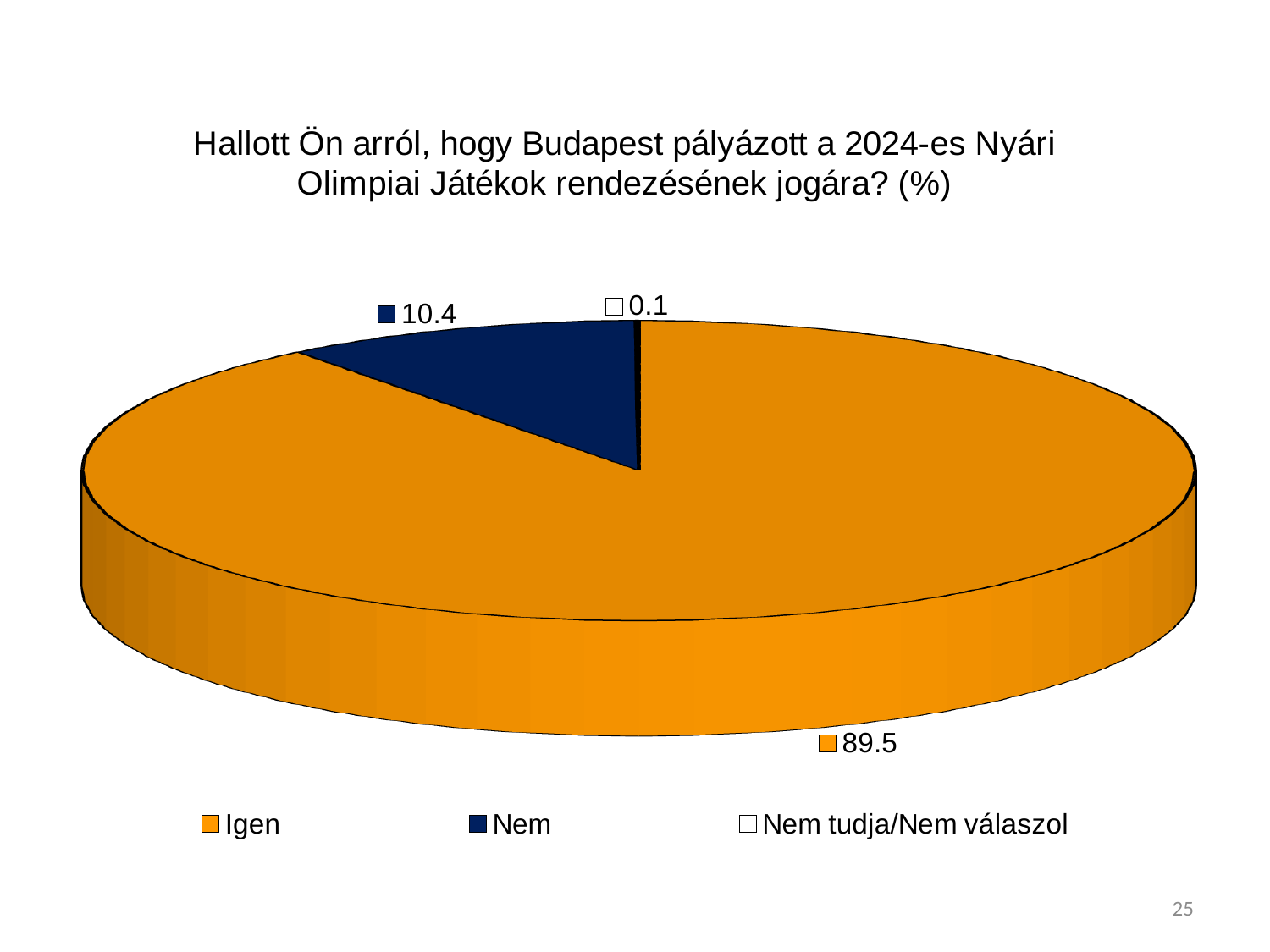
Which category has the largest slice? Igen What kind of chart is shown on the slide? Pie chart What colour is the "Nem" slice? Dark blue Which is larger, the value for "Nem" or the value for "Nem tudja/Nem válaszol"? Nem What is the title of the chart? Hallott Ön arról, hogy Budapest pályázott a 2024-es Nyári Olimpiai Játékok rendezésének jogára? (%) What is the value for "Igen"? 89.5 What is the difference between the values for "Igen" and "Nem"? 79.1 Which category has the smallest slice? Nem tudja/Nem válaszol How many slices does the pie chart have? 3 How many entries does the legend list? 3 What is the value for "Nem tudja/Nem válaszol"? 0.1 What is the value for "Nem"? 10.4